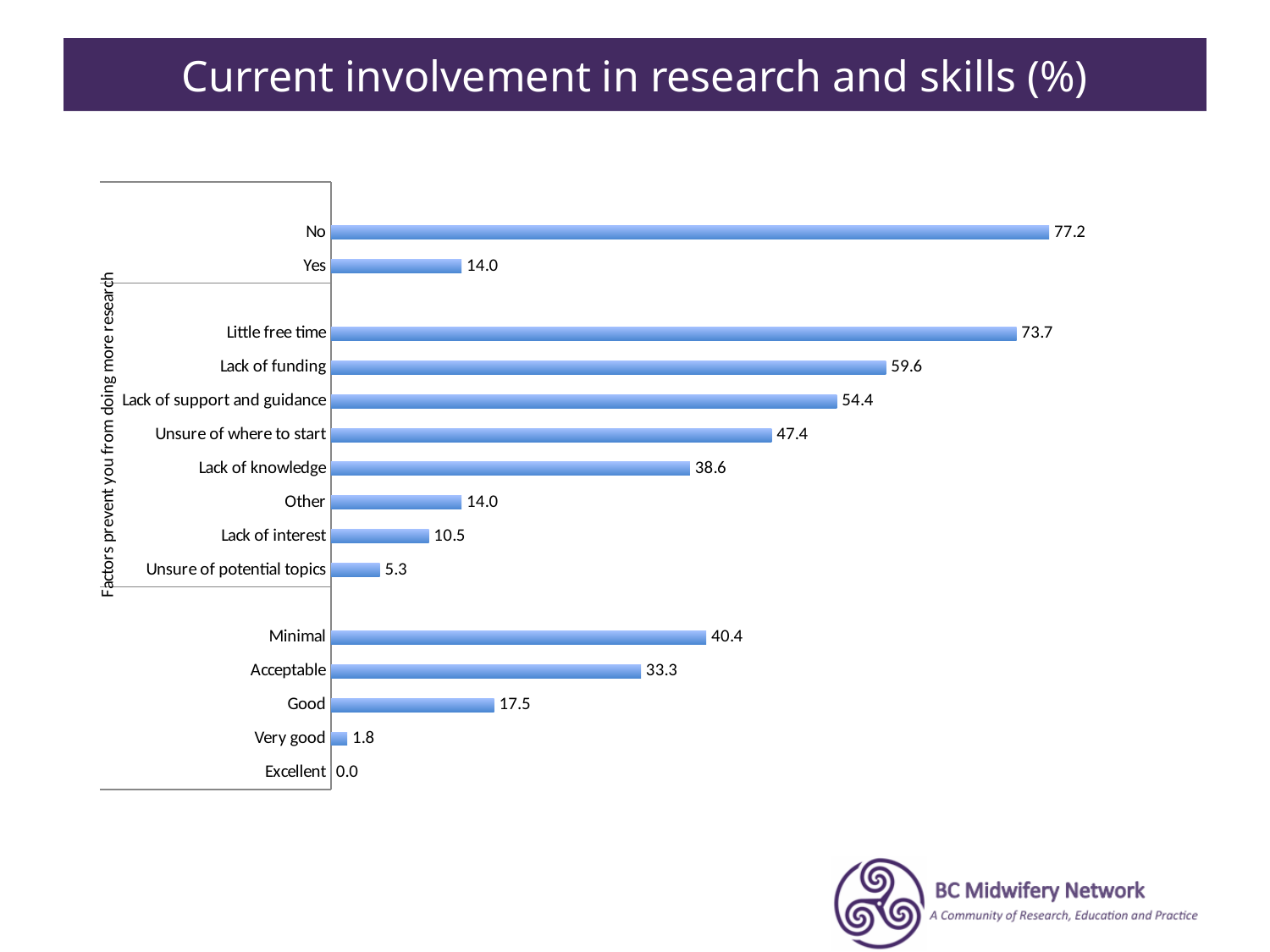
What is the value for "Lack of support and guidance"? 54.4 What kind of chart is shown on the slide? Bar chart Which is larger, the value for "Minimal" or the value for "Good"? Minimal What is the value for "Acceptable"? 33.3 Which category has the highest value on the chart? No How many categories are plotted on the chart? 15 What is the difference between the values for "No" and "Yes"? 63.2 What is the value for "Little free time"? 73.7 Which is larger, the value for "Unsure of where to start" or the value for "Lack of interest"? Unsure of where to start What is the difference between the values for "Lack of funding" and "Lack of knowledge"? 21.0 What is the title of the slide? Current involvement in research and skills (%) Which category has the lowest value on the chart? Excellent